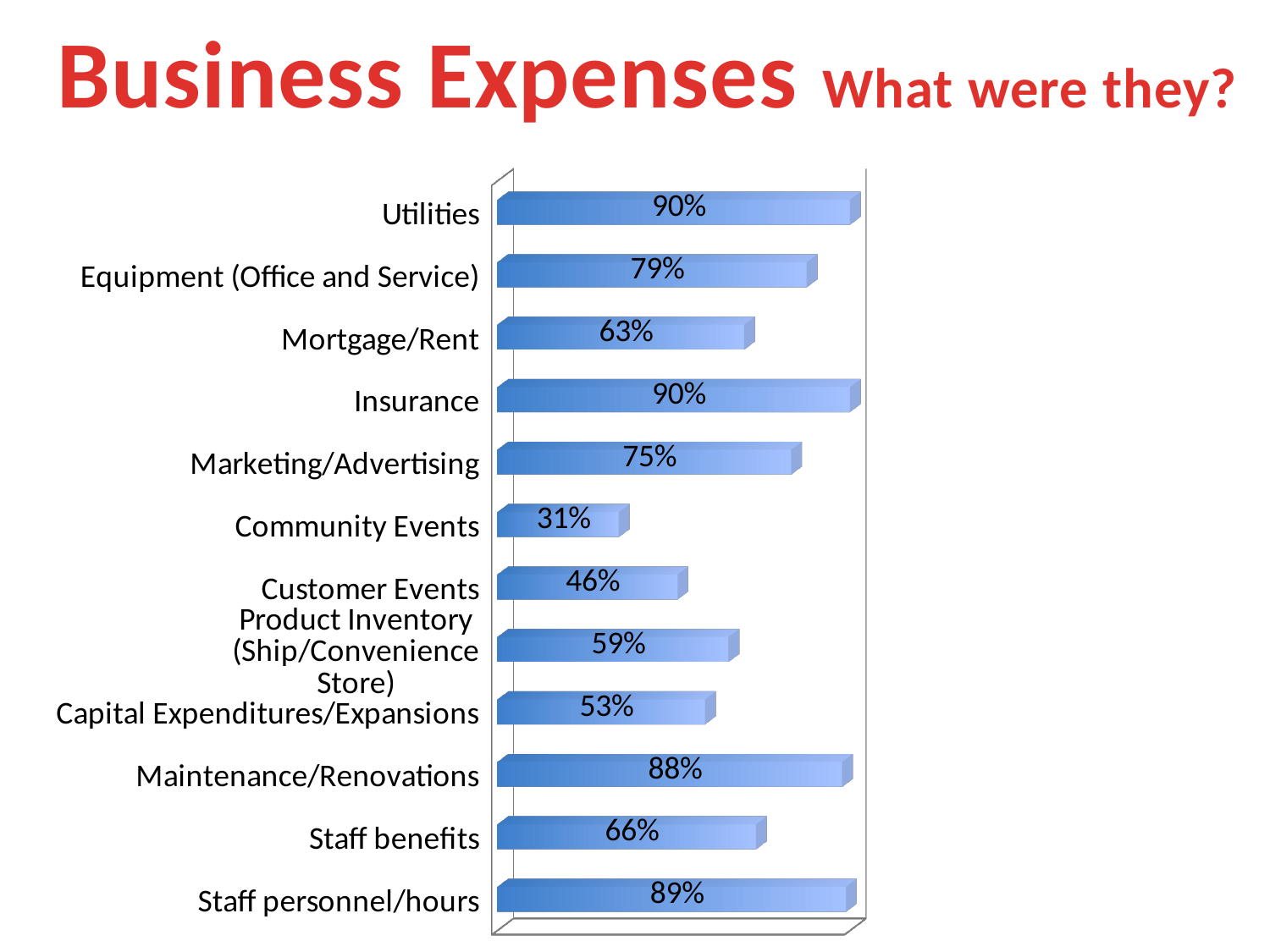
What is the difference between the values for Customer Events and Community Events? 15% Which category has the lowest value? Community Events What is the title of the slide? Business Expenses What were they? What is the value for Maintenance/Renovations? 88% Which is larger, the value for Marketing/Advertising or the value for Capital Expenditures/Expansions? Marketing/Advertising Which is larger, the value for Staff personnel/hours or the value for Staff benefits? Staff personnel/hours What is the value for Community Events? 31% What is the difference between the values for Equipment (Office and Service) and Mortgage/Rent? 16% What kind of chart is shown on the slide? Bar chart What is the value for Staff benefits? 66% How many categories are shown in the chart? 12 What is the value for Utilities? 90%